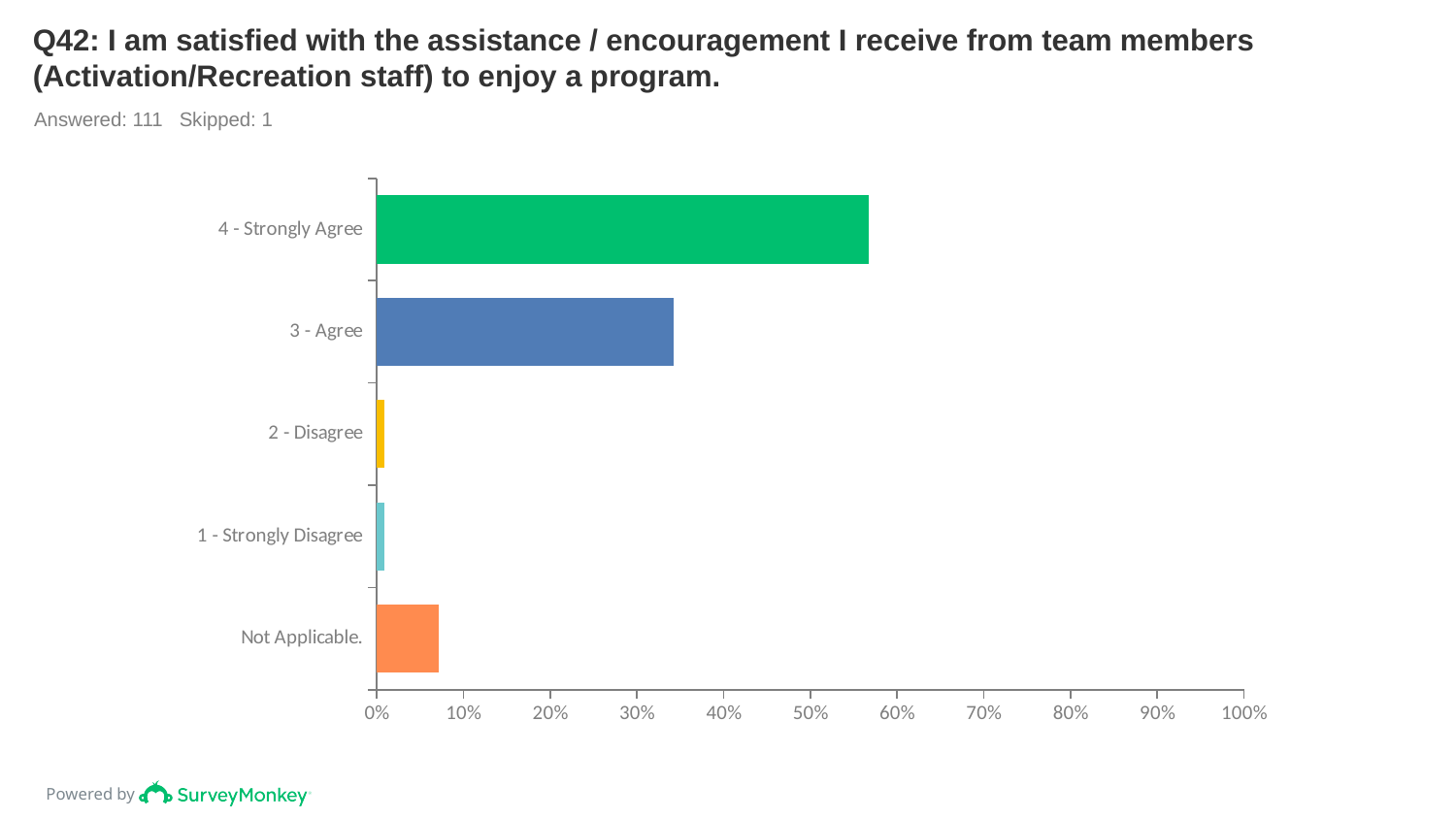
Is the value for 2 - Disagree greater or less than 10%? less Is the value for 3 - Agree greater or less than 40%? less What is the highest value shown on the horizontal axis? 100% Is the value for 4 - Strongly Agree greater or less than 50%? greater What kind of chart is shown on the slide? bar chart How many respondents answered this question according to the slide? 111 How many response categories are shown on the chart? 5 Which is larger, the value for Not Applicable. or the value for 1 - Strongly Disagree? Not Applicable. Which response category has the highest value? 4 - Strongly Agree Which is larger, the value for 3 - Agree or the value for Not Applicable.? 3 - Agree